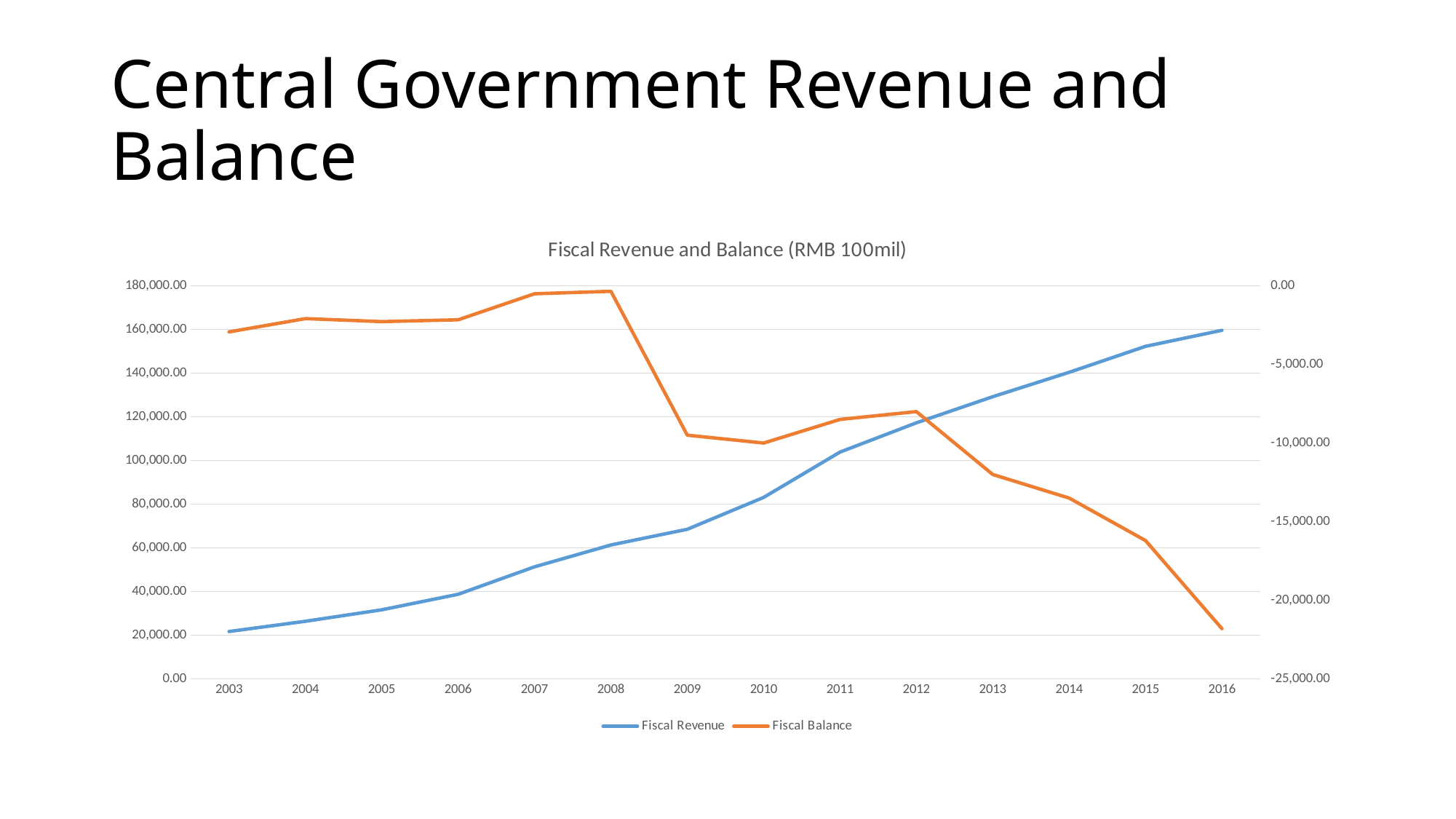
How many years are plotted along the x axis? 14 What is the title of the chart? Fiscal Revenue and Balance (RMB 100mil) Is the Fiscal Revenue value for 2016 greater or less than 140,000.00? greater What kind of chart is shown on the slide? line chart How many series does the legend list? 2 In which year is Fiscal Revenue lowest? 2003 Does Fiscal Revenue rise or fall from 2003 to 2016? rise Does Fiscal Balance rise or fall from 2012 to 2016? fall In which year is Fiscal Revenue highest? 2016 Is the Fiscal Balance value for 2009 greater or less than -5,000.00? less In which year is Fiscal Balance lowest? 2016 Which colour is used for the Fiscal Balance line? orange